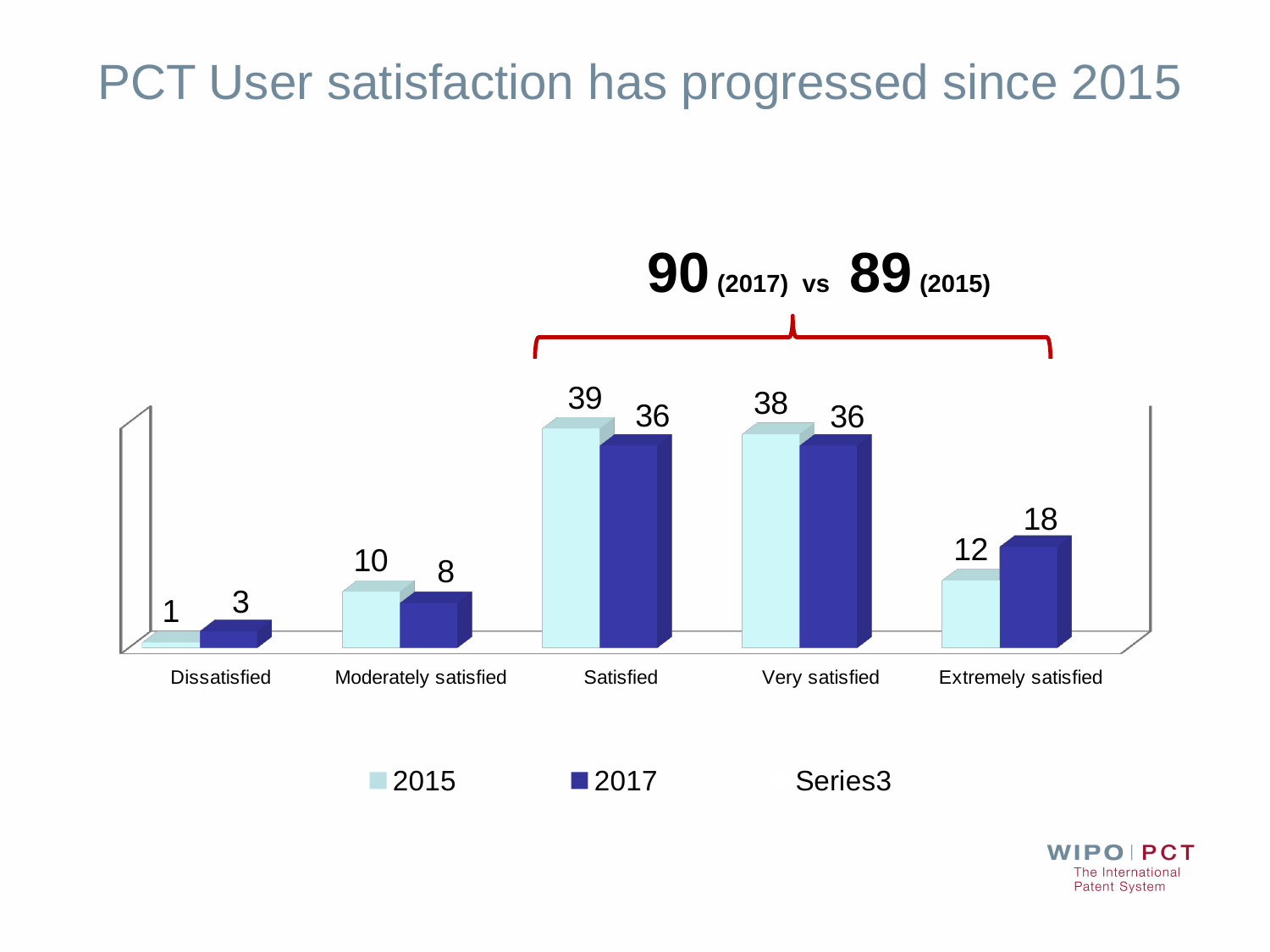
What is the 2017 value for Dissatisfied? 3 How many categories are shown on the x axis? 5 Which category has the lowest 2017 value? Dissatisfied What is the 2015 value for Moderately satisfied? 10 What is the title of the slide? PCT User satisfaction has progressed since 2015 How many series does the legend list? 3 What kind of chart is shown on the slide? Bar chart What is the 2017 value for Extremely satisfied? 18 Which is larger for Very satisfied, the 2015 value or the 2017 value? 2015 What is the 2015 value for Satisfied? 39 Which category has the highest 2015 value? Satisfied What is the difference between the 2017 and 2015 values for Extremely satisfied? 6